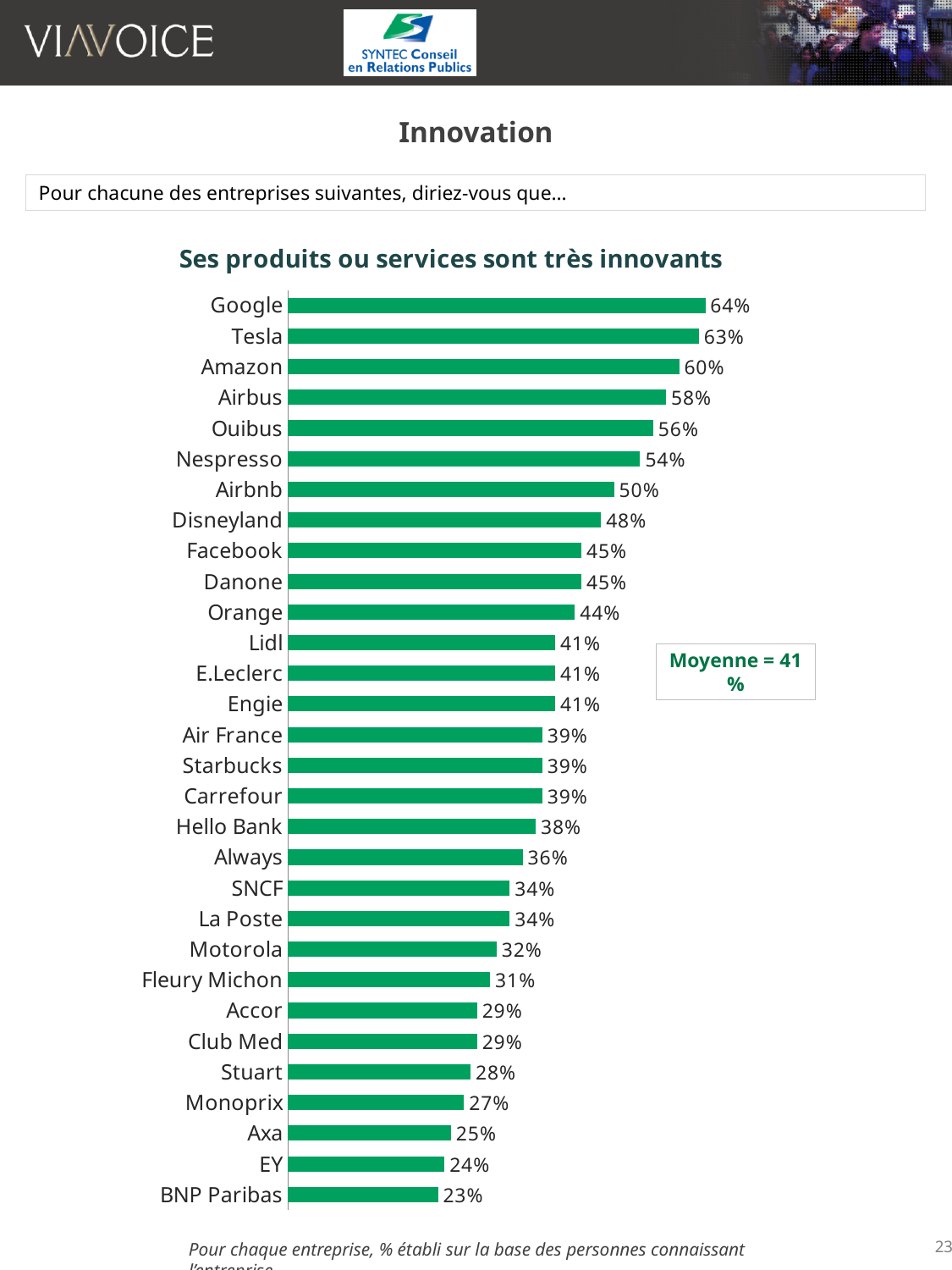
Which company has the highest value? Google Which has a larger value, Nespresso or Disneyland? Nespresso Which has a larger value, Motorola or Always? Always What is the value for Airbnb? 50% What is the difference between the values for Tesla and Amazon? 3% How many companies are shown in the chart? 30 What is the difference between the values for Google and BNP Paribas? 41% What kind of chart is shown? Bar chart What is the value for Fleury Michon? 31% What is the value for Google? 64% Which company has the lowest value? BNP Paribas What average (Moyenne) is indicated on the chart? 41 %